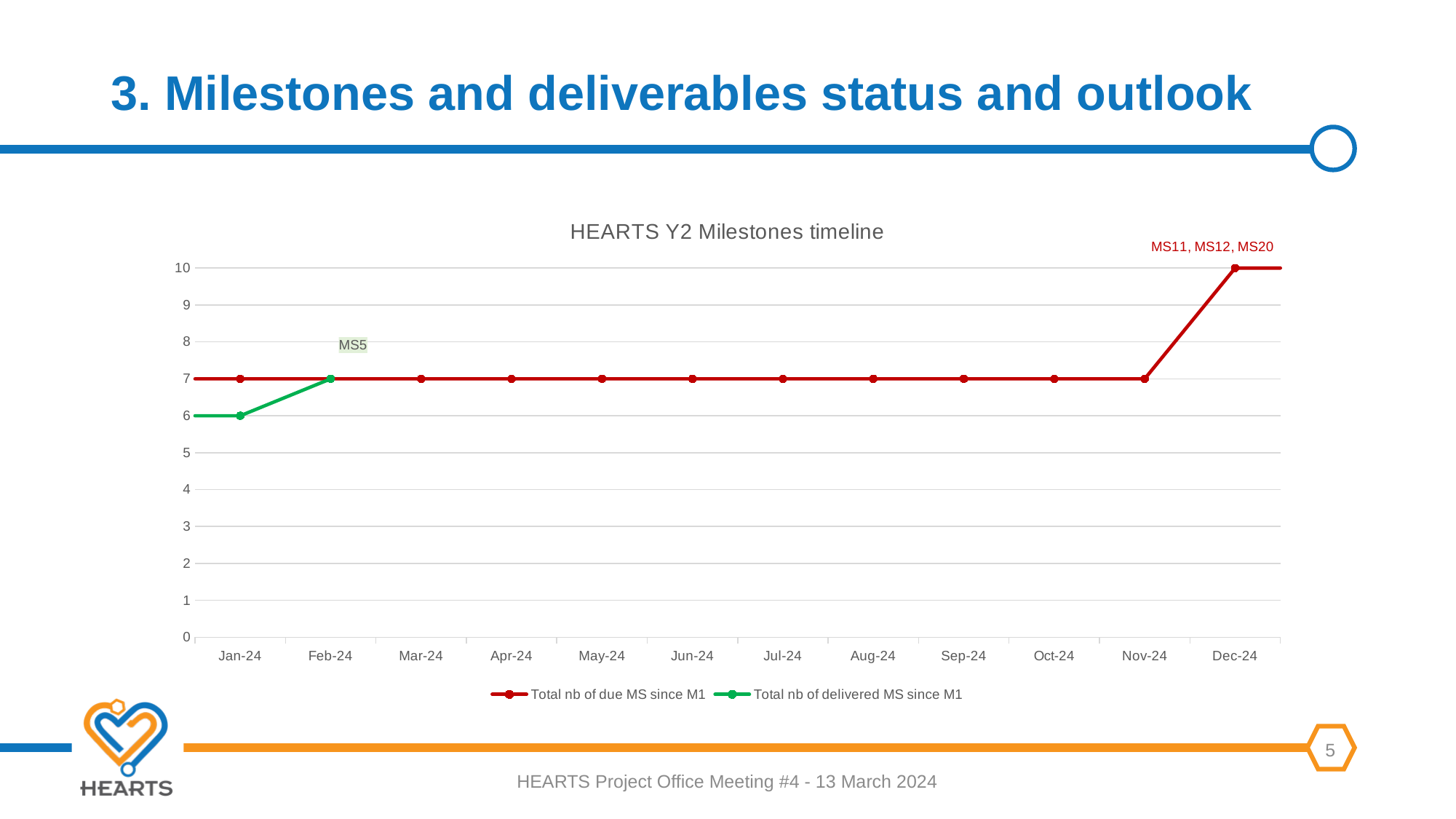
What kind of chart is shown on the slide? line chart What is the title of the chart? HEARTS Y2 Milestones timeline What is the value of 'Total nb of due MS since M1' in Jan-24? 7 What is the difference between 'Total nb of due MS since M1' in Dec-24 and in Nov-24? 3 How many months are shown on the x axis? 12 What is the value of 'Total nb of due MS since M1' in Dec-24? 10 Does 'Total nb of due MS since M1' rise or fall between Nov-24 and Dec-24? rise What is the value of 'Total nb of delivered MS since M1' in Feb-24? 7 In Jan-24, which is larger: 'Total nb of due MS since M1' or 'Total nb of delivered MS since M1'? Total nb of due MS since M1 In which month does 'Total nb of due MS since M1' reach its highest value? Dec-24 How many series does the legend list? 2 What is the value of 'Total nb of delivered MS since M1' in Jan-24? 6